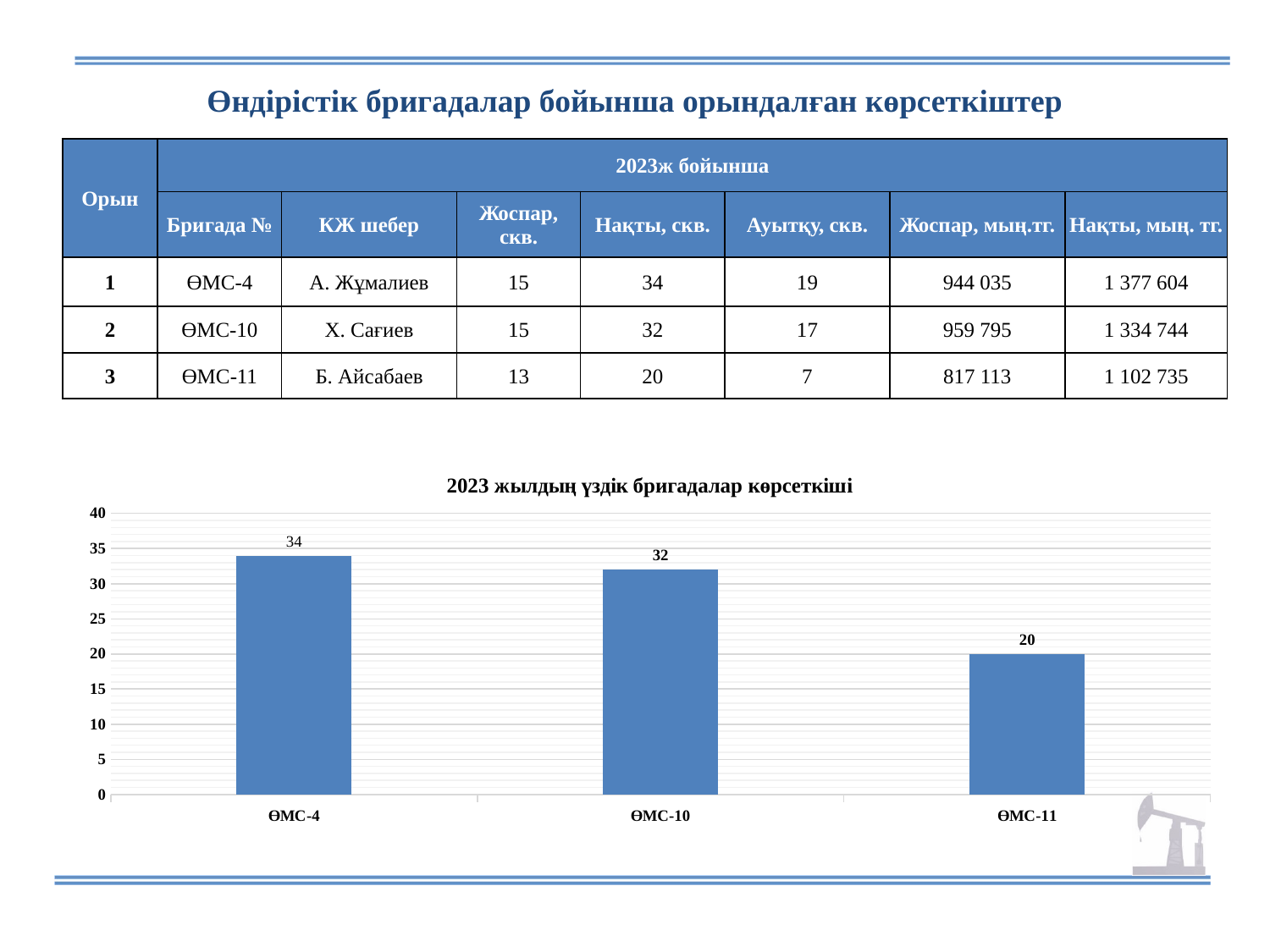
What is the title of the chart? 2023 жылдың үздік бригадалар көрсеткіші Which category has the lowest value in the chart? ӨМС-11 Which is larger, the value for ӨМС-10 or the value for ӨМС-11? ӨМС-10 What is the value for ӨМС-10 in the chart? 32 Which category has the highest value in the chart? ӨМС-4 What is the value for ӨМС-4 in the chart? 34 What kind of chart is shown on the slide? bar chart What is the value for ӨМС-11 in the chart? 20 Is the value for ӨМС-11 greater or less than 25? less How many categories are shown in the chart? 3 What is the difference between the values for ӨМС-4 and ӨМС-11? 14 What is the difference between the values for ӨМС-10 and ӨМС-11? 12